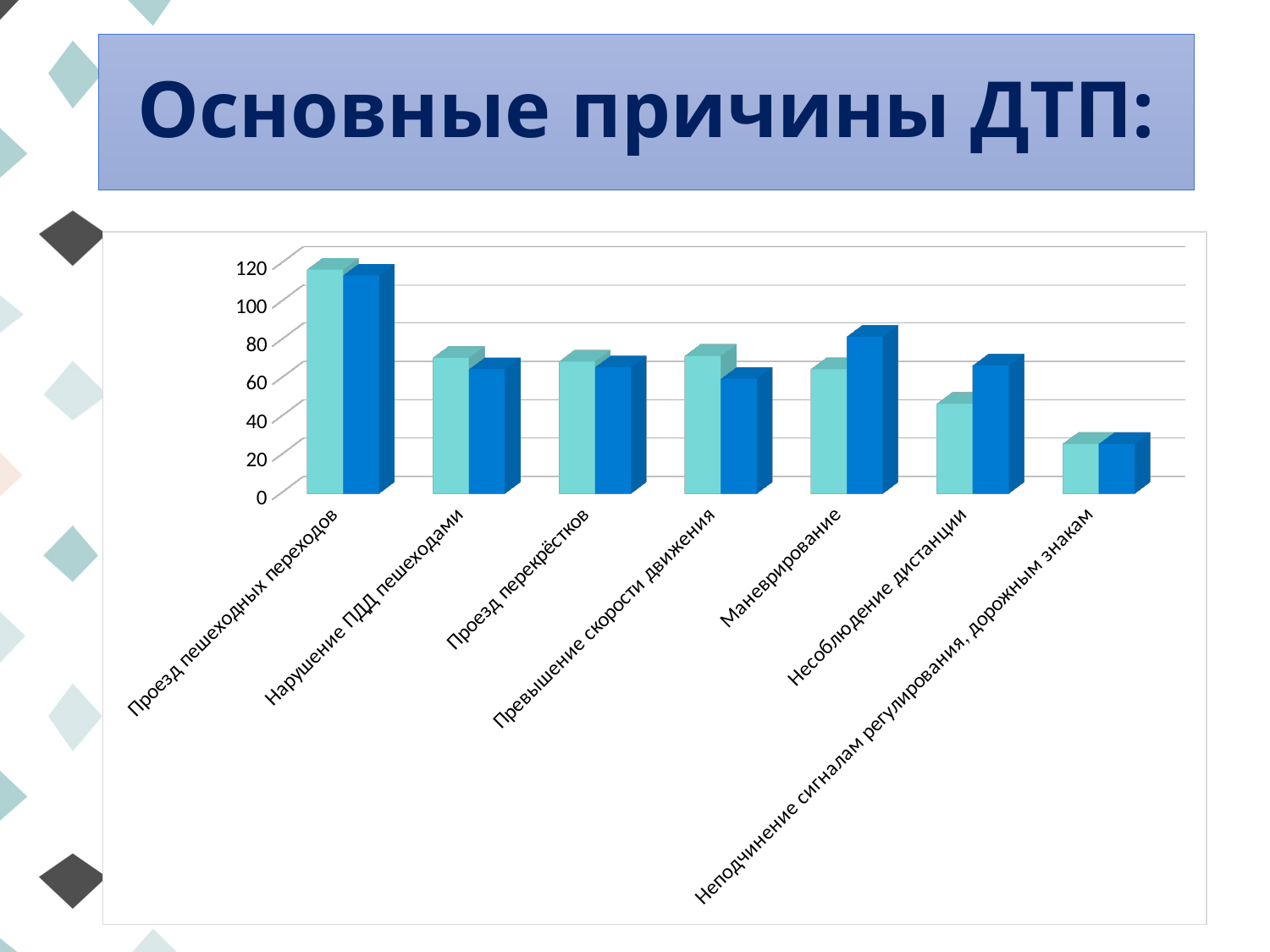
What kind of chart is shown on the slide? Bar chart Which category has the lowest dark-blue bar in the chart? Неподчинение сигналам регулирования, дорожным знакам Which category has the highest light-blue bar in the chart? Проезд пешеходных переходов Is the light-blue bar for Несоблюдение дистанции greater or less than 60? less Is the dark-blue bar for Маневрирование greater or less than 60? greater How many bars are plotted for each category in the chart? 2 What is the title of the slide containing the chart? Основные причины ДТП: Is the light-blue bar for Неподчинение сигналам регулирования, дорожным знакам greater or less than 40? less Which is larger: the light-blue bar for Проезд пешеходных переходов or the light-blue bar for Маневрирование? Проезд пешеходных переходов How many categories are shown on the x axis of the chart? 7 For Маневрирование, which bar is taller: the light-blue bar or the dark-blue bar? the dark-blue bar